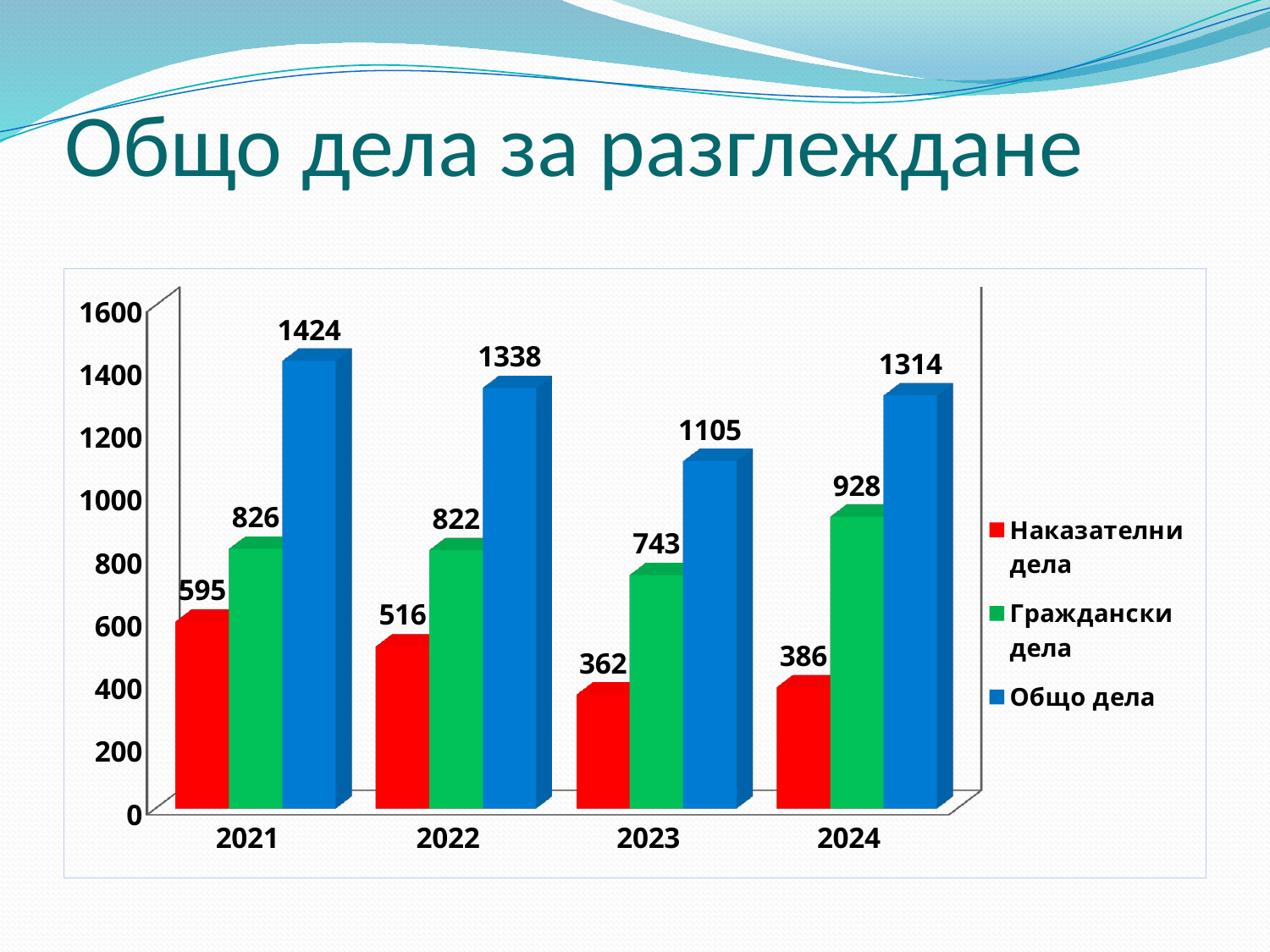
What kind of chart is shown on the slide? bar chart What is the value for Наказателни дела in 2021? 595 Which is larger: Граждански дела in 2021 or in 2022? 2021 Is the value for Наказателни дела in 2022 greater or less than 600? less What is the value for Граждански дела in 2024? 928 In which year is Наказателни дела lowest? 2023 What is the title of the slide? Общо дела за разглеждане What is the value for Общо дела in 2023? 1105 What is the difference between Общо дела in 2021 and in 2022? 86 In which year is Общо дела highest? 2021 How many series does the legend list? 3 How many years are shown on the x axis? 4